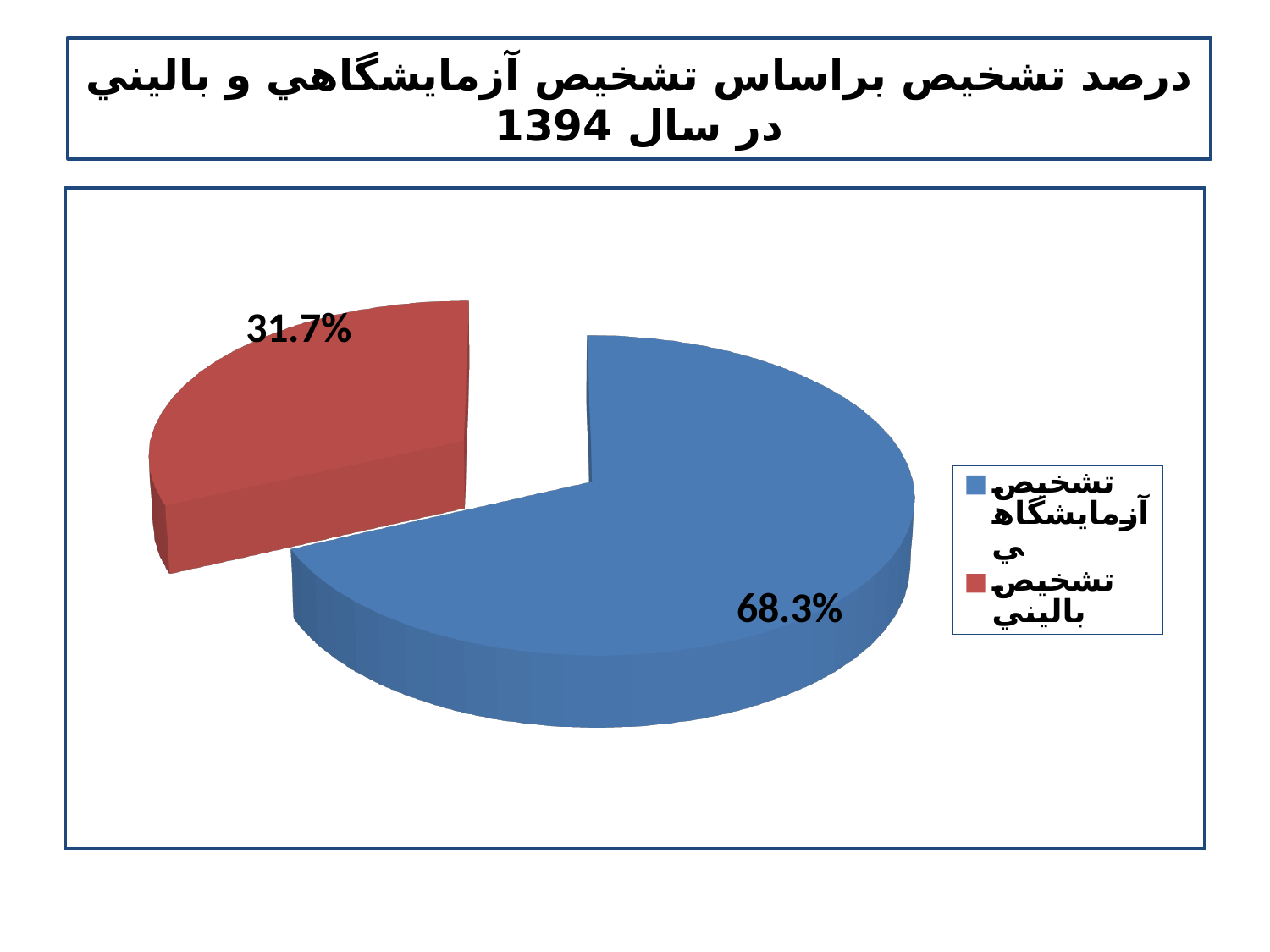
Which is larger: the share for تشخيص آزمايشگاهي or the share for تشخيص باليني? تشخيص آزمايشگاهي How many entries does the legend list? 2 How many slices does the pie chart have? 2 Which category has the largest share of the pie? تشخيص آزمايشگاهي What is the difference in percentage points between the laboratory diagnosis slice and the clinical diagnosis slice? 36.6 What share of the pie does the red slice represent? 31.7% What percentage of the pie is labelled for تشخيص باليني (clinical diagnosis)? 31.7% What kind of chart is shown on the slide? Pie chart What colour is the slice for تشخيص آزمايشگاهي? Blue What percentage of the pie is labelled for تشخيص آزمايشگاهي (laboratory diagnosis)? 68.3% Which year is mentioned in the chart title? 1394 Which category has the smallest share of the pie? تشخيص باليني